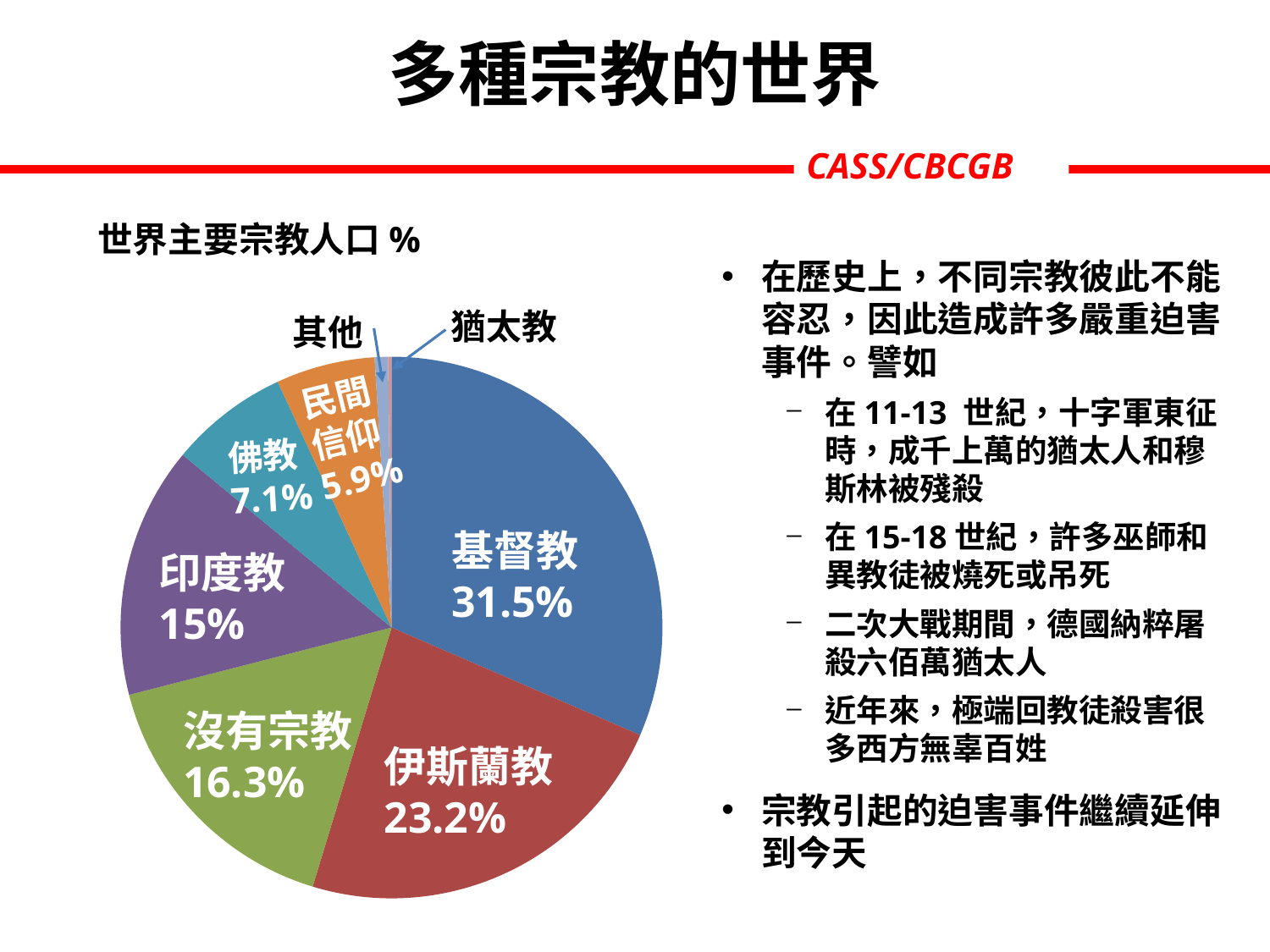
Which is larger, the share for 沒有宗教 or the share for 印度教? 沒有宗教 Which slice of the pie chart is the largest? 基督教 What is the difference in percentage points between 基督教 and 伊斯蘭教? 8.3 What percentage does the chart show for 民間信仰? 5.9% What percentage does the chart show for 伊斯蘭教? 23.2% What percentage does the chart show for 佛教? 7.1% What percentage does the chart show for 印度教? 15% What is the title of the chart? 世界主要宗教人口 % What kind of chart is shown on the slide? Pie chart What percentage does the chart show for 沒有宗教? 16.3% What percentage does the chart show for 基督教? 31.5% How many slices does the pie chart have? 8